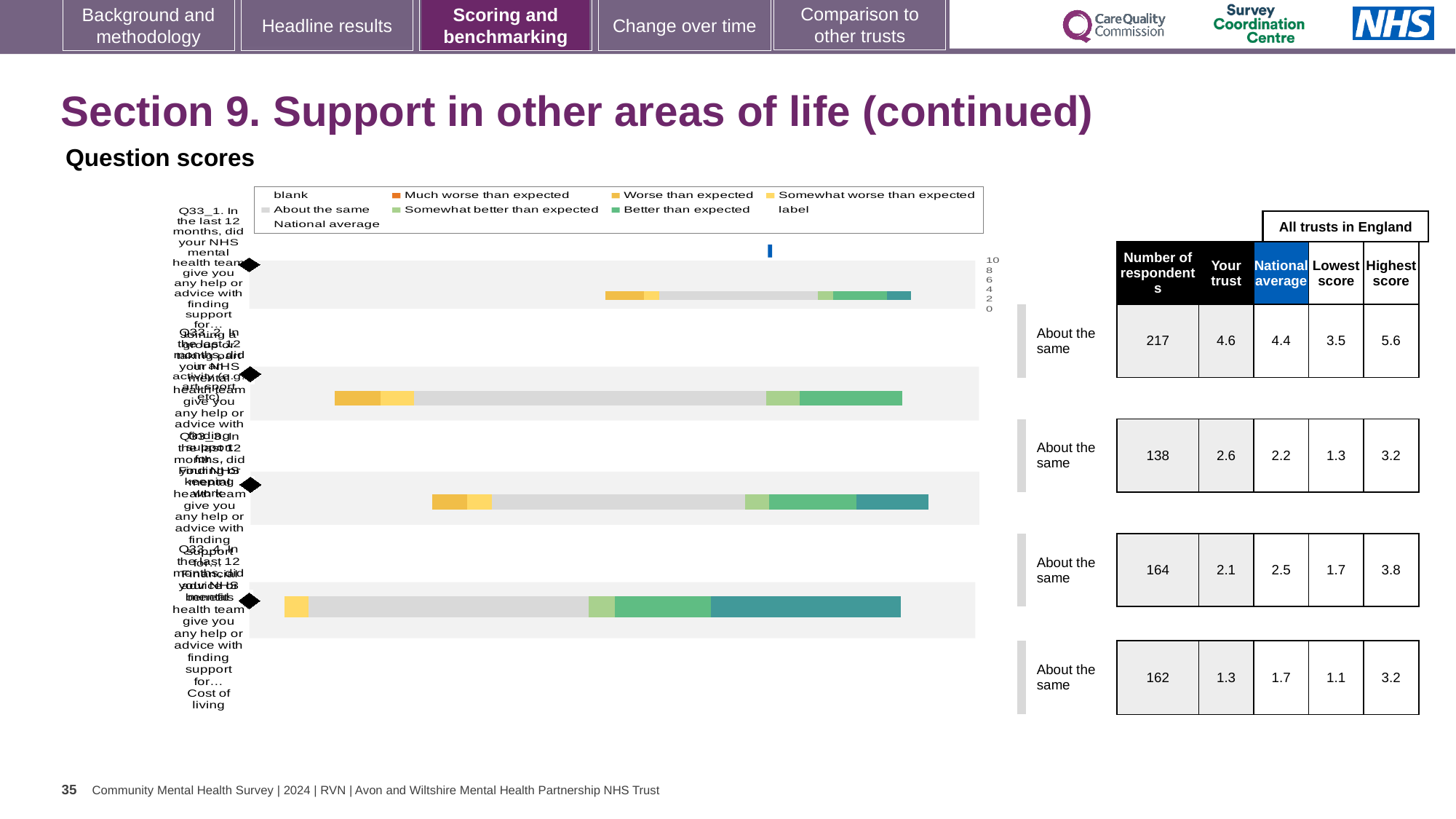
In the table beside the chart, what is the highest score among all trusts in England for Q33_1? 5.6 In the table beside the chart, what is the national average for Q33_2? 2.2 For Q33_3, which is larger: the 'Your trust' score or the national average? National average What is the heading above the chart? Question scores For Q33_1, what is the difference between the 'Your trust' score and the national average? 0.2 Which question has the lowest number of respondents in the table beside the chart? Q33_2 Which question has the highest 'Your trust' score in the table beside the chart? Q33_1 How many questions (bars) are plotted in the Question scores chart? 4 In the table beside the chart, what is the 'Your trust' score for Q33_4 (Cost of living)? 1.3 In the table beside the chart, what is the number of respondents for Q33_1? 217 What kind of chart is shown under 'Question scores'? bar chart What benchmark label is shown next to each of the four bars in the chart? About the same